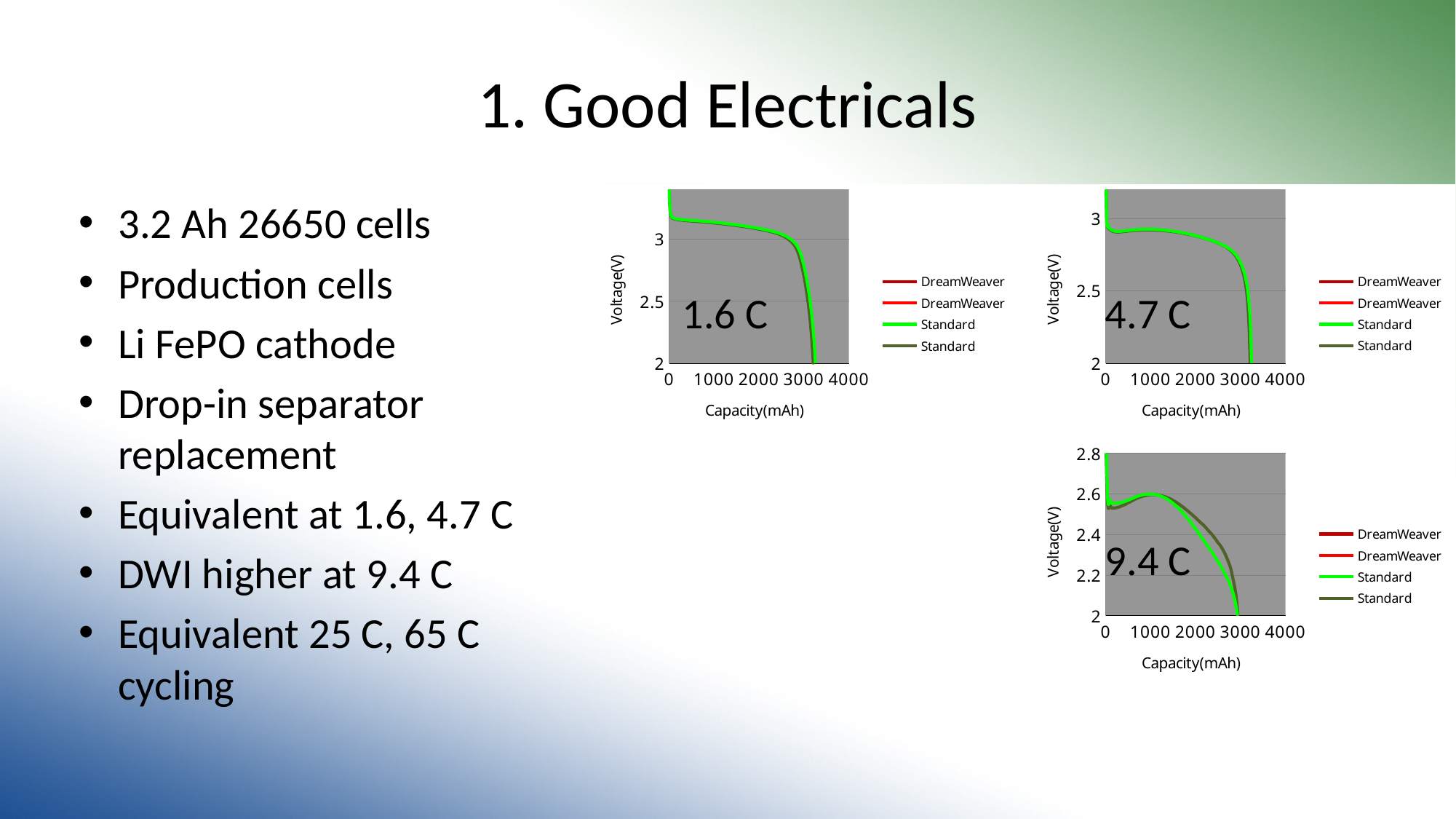
How many charts are shown on the slide? 3 In the 4.7 C chart, is the voltage at 1000 mAh greater or less than 3? less In the 9.4 C chart, is the voltage at 1000 mAh greater or less than 2.4? greater In the 9.4 C chart, is the voltage at 2000 mAh greater or less than 2.2? greater In the 4.7 C chart, does the voltage rise or fall as capacity increases from 1000 to 3000 mAh? fall In the 1.6 C chart, does the voltage rise or fall as capacity increases? fall How many series does the legend of the 4.7 C chart list? 4 In the 9.4 C chart, what is the label of the y axis? Voltage(V) What kind of chart is the 1.6 C chart? line chart In the 9.4 C chart, what is the highest value shown on the y axis? 2.8 In the 1.6 C chart, what is the label of the x axis? Capacity(mAh)